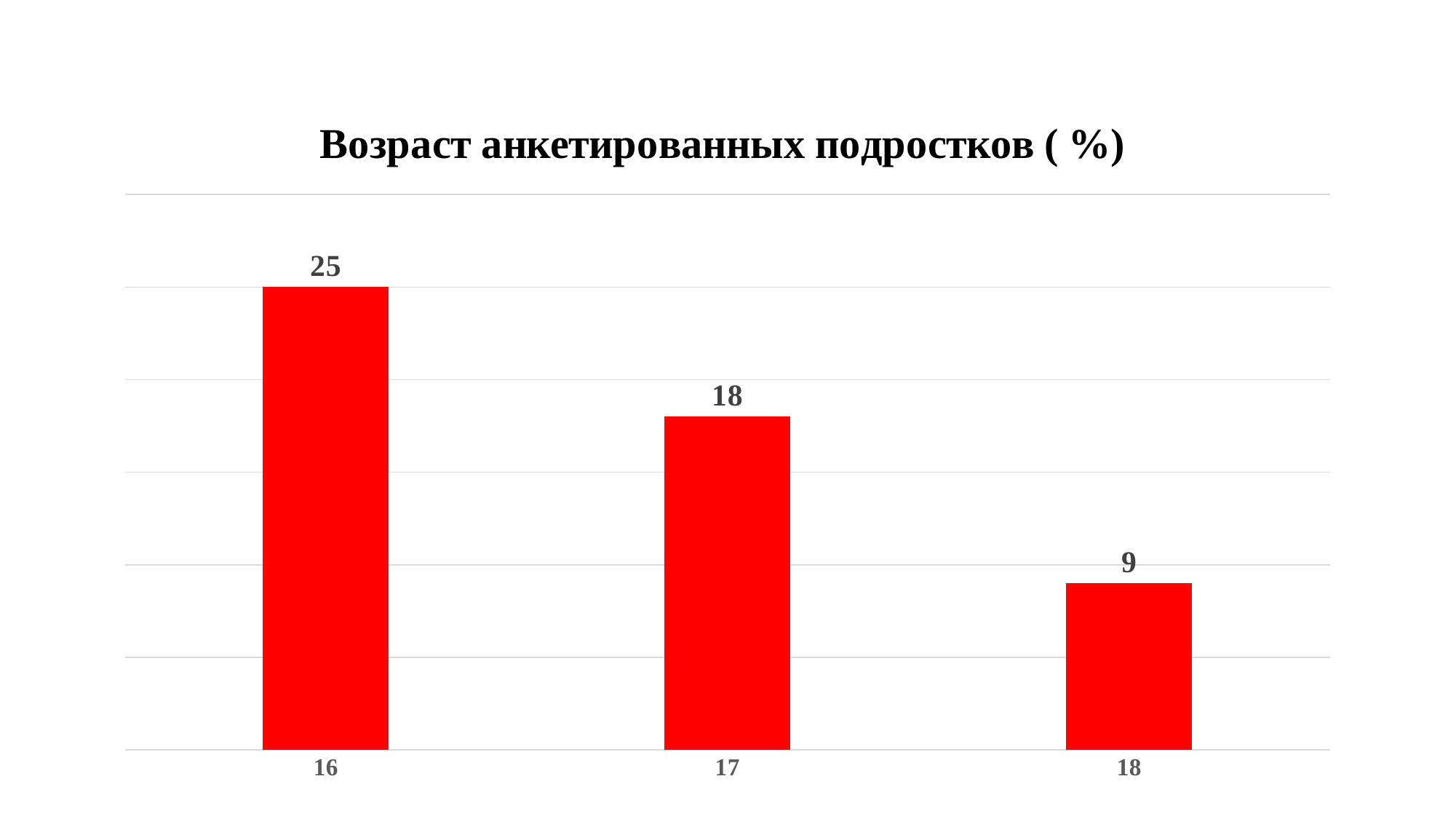
What is the value for age 16? 25 What is the difference between the values for age 16 and age 18? 16 What is the difference between the values for age 16 and age 17? 7 How many age categories are shown in the chart? 3 Which is larger, the value for age 17 or the value for age 18? 17 Which age category has the highest value? 16 Do the values rise or fall from age 16 to age 18? fall What is the title of the chart? Возраст анкетированных подростков ( %) What kind of chart is shown on the slide? bar chart Which age category has the lowest value? 18 What is the value for age 17? 18 What is the value for age 18? 9